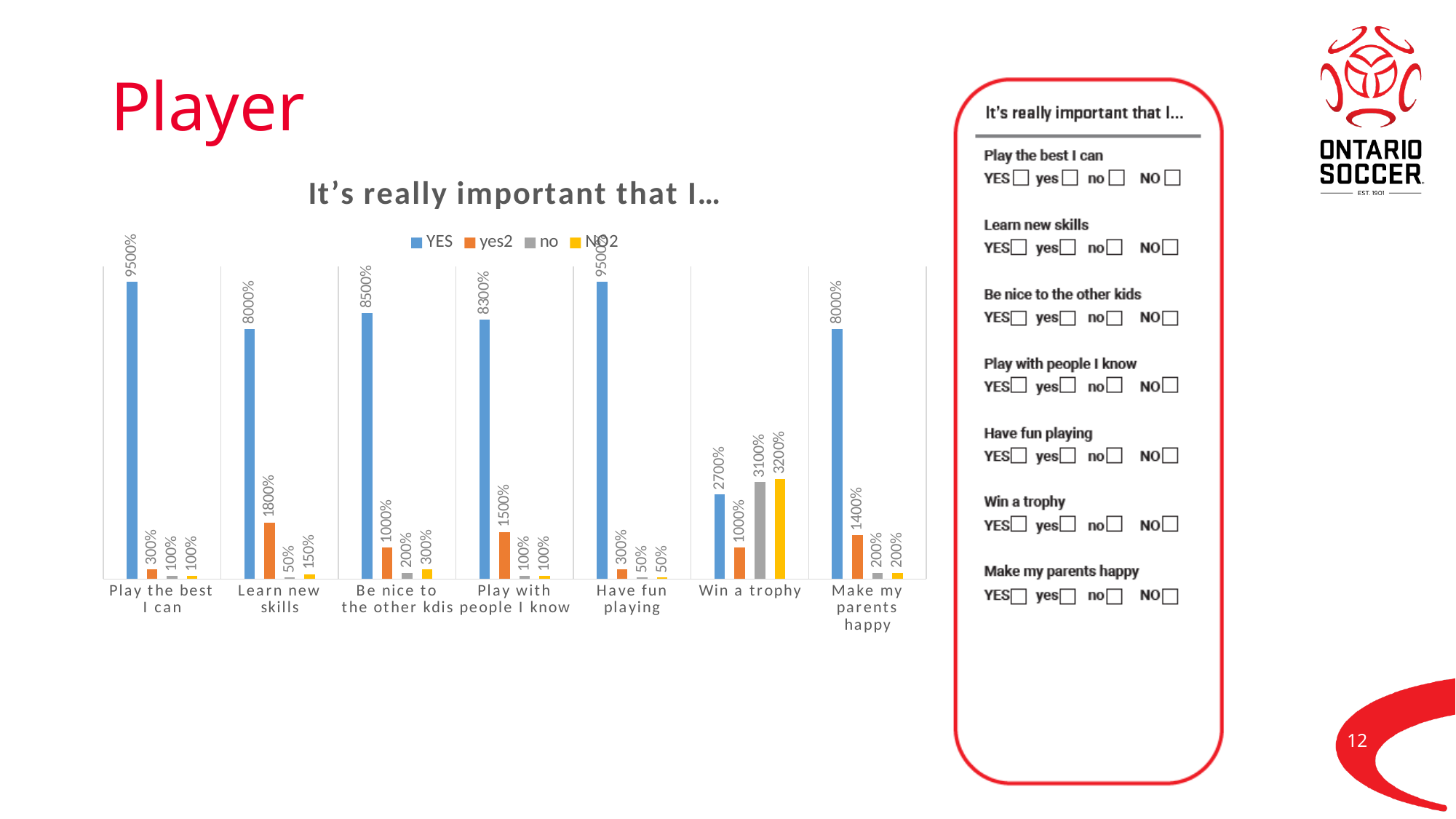
What kind of chart is shown on the slide? Bar chart What is the difference between the YES values for "Play the best I can" and "Win a trophy"? 6800% What is the title of the chart? It's really important that I… What is the NO2 value for "Win a trophy"? 3200% How many series does the legend list? 4 What is the YES value for "Learn new skills"? 8000% What is the yes2 value for "Make my parents happy"? 1400% What is the yes2 value for "Win a trophy"? 1000% Which is larger for "Win a trophy": the no value or the NO2 value? NO2 How many categories are shown on the x axis? 7 Which category has the lowest YES value? Win a trophy Which category has the highest yes2 value? Learn new skills